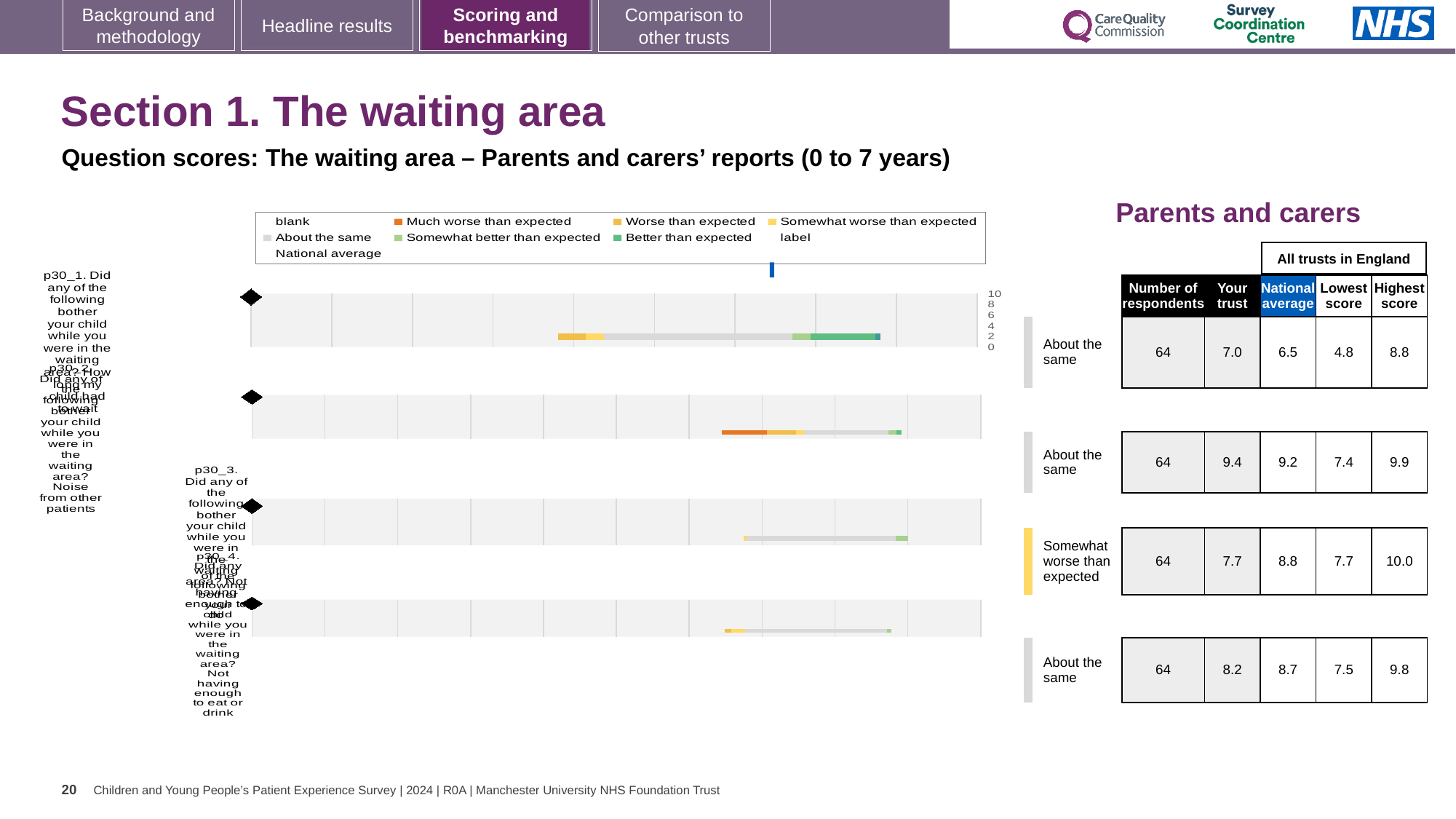
In the table next to the chart, what is the highest score for the third row (p30_3, not having enough to do)? 10.0 How many entries does the chart legend list? 9 What kind of chart is shown on the slide? bar chart In the table next to the chart, is the 'Your trust' score for the third row (7.7) larger or smaller than its national average (8.8)? smaller In the table next to the chart, how many respondents are listed for each question? 64 In the table next to the chart, what is the national average for the second row (p30_2, noise from other patients)? 9.2 In the chart legend, what colour represents 'Much worse than expected'? orange In the table next to the chart, what is the 'Your trust' score for the first row (p30_1)? 7.0 In the table next to the chart, what is the lowest score for the fourth row (p30_4, not having enough to eat or drink)? 7.5 In the table next to the chart, which row has the highest 'Your trust' score? p30_2 (noise from other patients), 9.4 How many question bars are plotted in the chart? 4 In the chart legend, what colour represents 'Better than expected'? green